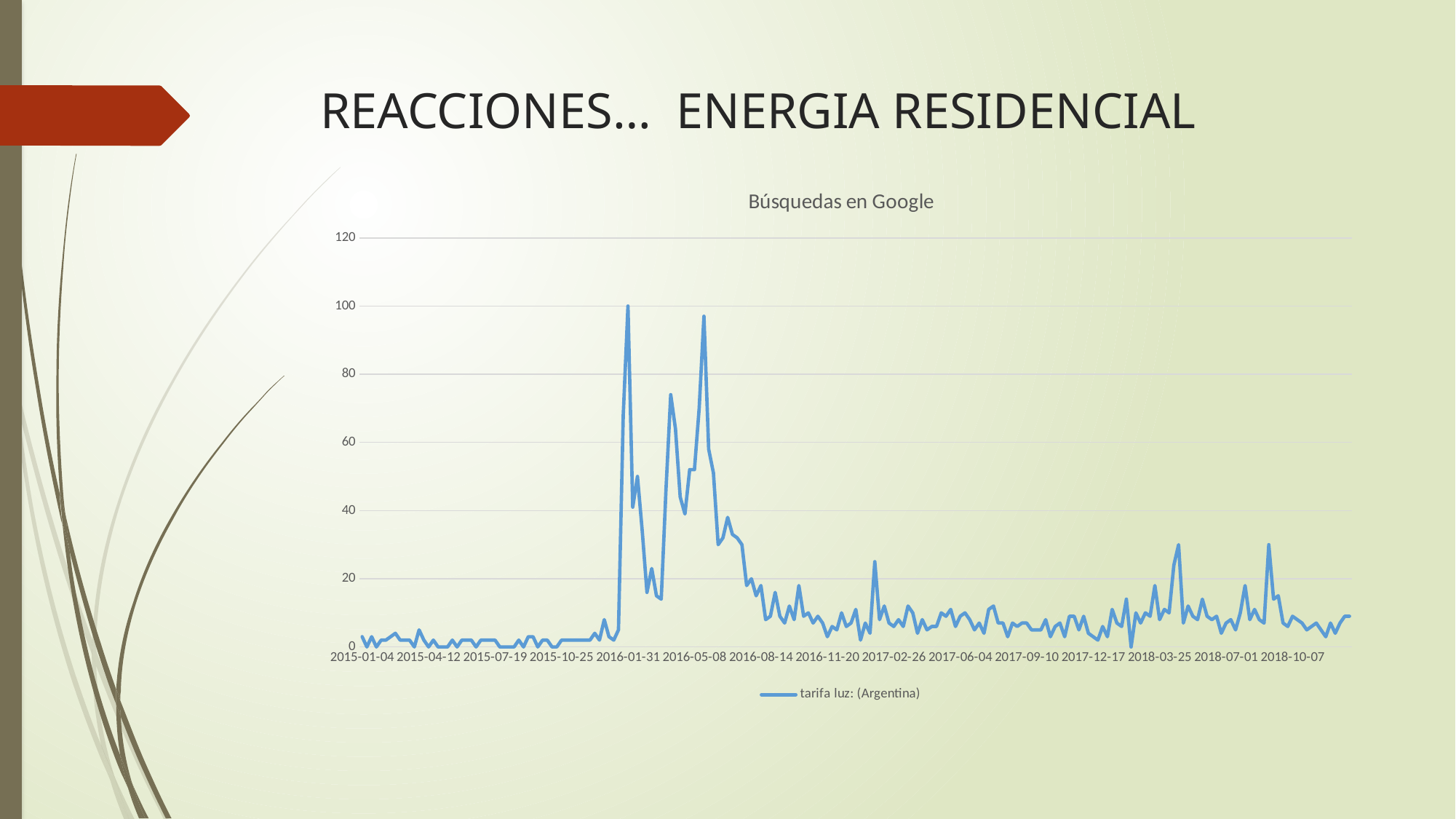
Is the peak value of the line greater or less than 80? greater What is the name of the series shown in the legend? tarifa luz: (Argentina) Which is larger, the value near 2016-01-31 or the value at 2015-01-04? 2016-01-31 What is the title of the chart? Búsquedas en Google What is the highest value reached by the line, as read against the y-axis ticks? 100 Around which x-axis label does the line reach its highest value? 2016-01-31 How many series does the legend list? 1 From the peak in early 2016 to the end of 2018, does the line generally rise or fall? fall Is the value at 2015-01-04 greater or less than 20? less How many date labels are shown on the x axis? 15 Is the value at 2017-09-10 greater or less than 20? less What kind of chart is shown on the slide? line chart